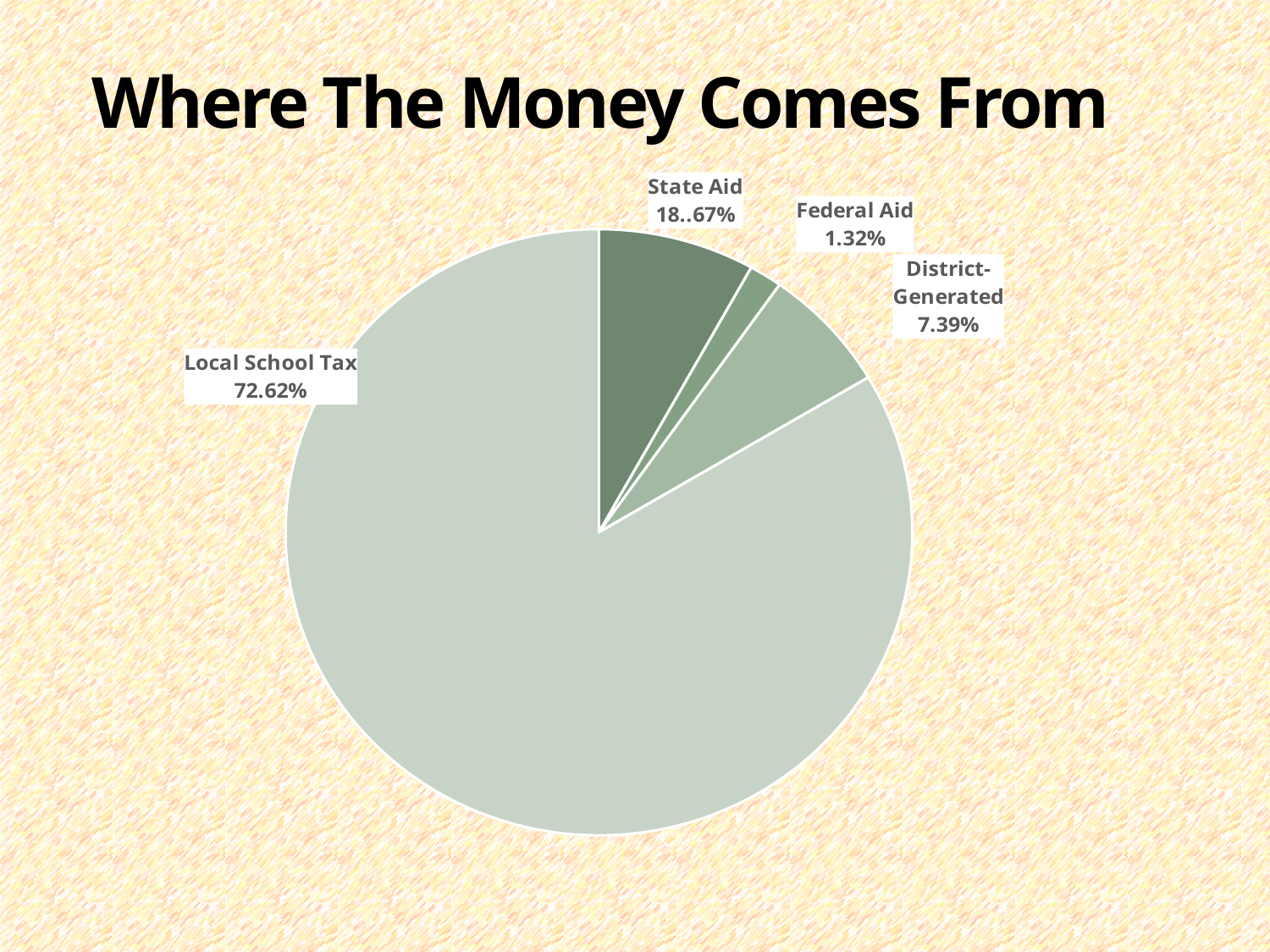
What share of the money is District-Generated? 7.39% Which is larger, the share from Federal Aid or the share from District-Generated? District-Generated Which source provides the smallest share of the money? Federal Aid What is the title of the chart? Where The Money Comes From What is the difference in percentage points between the District-Generated share and the Federal Aid share? 6.07 Which source provides the largest share of the money? Local School Tax What is the difference in percentage points between the Local School Tax share and the District-Generated share? 65.23 How many sources (slices) are shown in the pie chart? 4 What share of the money comes from Federal Aid? 1.32% What type of chart is shown on the slide? pie chart What share of the money comes from Local School Tax? 72.62% Which is larger, the share from State Aid or the share from District-Generated? State Aid